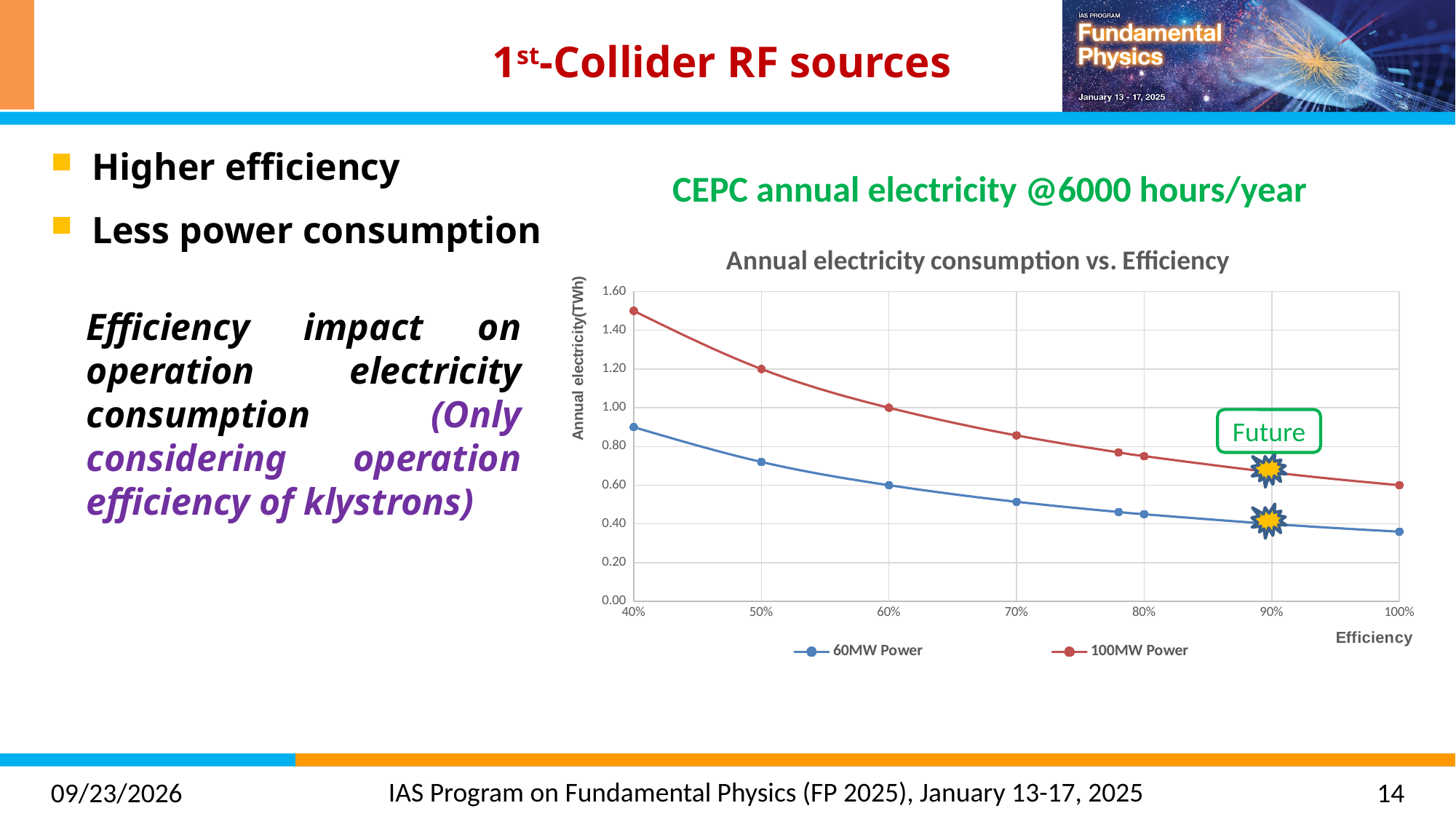
What is the annual electricity consumption for 60MW Power at 60% efficiency? 0.60 At 70% efficiency, which series has the higher annual electricity consumption, 60MW Power or 100MW Power? 100MW Power Is the value for 60MW Power at 40% efficiency greater or less than 0.80? greater What is the title of the chart? Annual electricity consumption vs. Efficiency Is the value for 60MW Power at 100% efficiency greater or less than 0.40? less Do the annual electricity consumption values rise or fall as efficiency increases along the x axis? Fall What kind of chart is shown on the slide? Line chart How many series does the chart legend list? 2 What are the two series named in the chart legend? 60MW Power and 100MW Power What is the annual electricity consumption for 100MW Power at 50% efficiency? 1.20 What is the annual electricity consumption for 100MW Power at 100% efficiency? 0.60 Is the value for 100MW Power at 40% efficiency greater or less than 1.40? greater